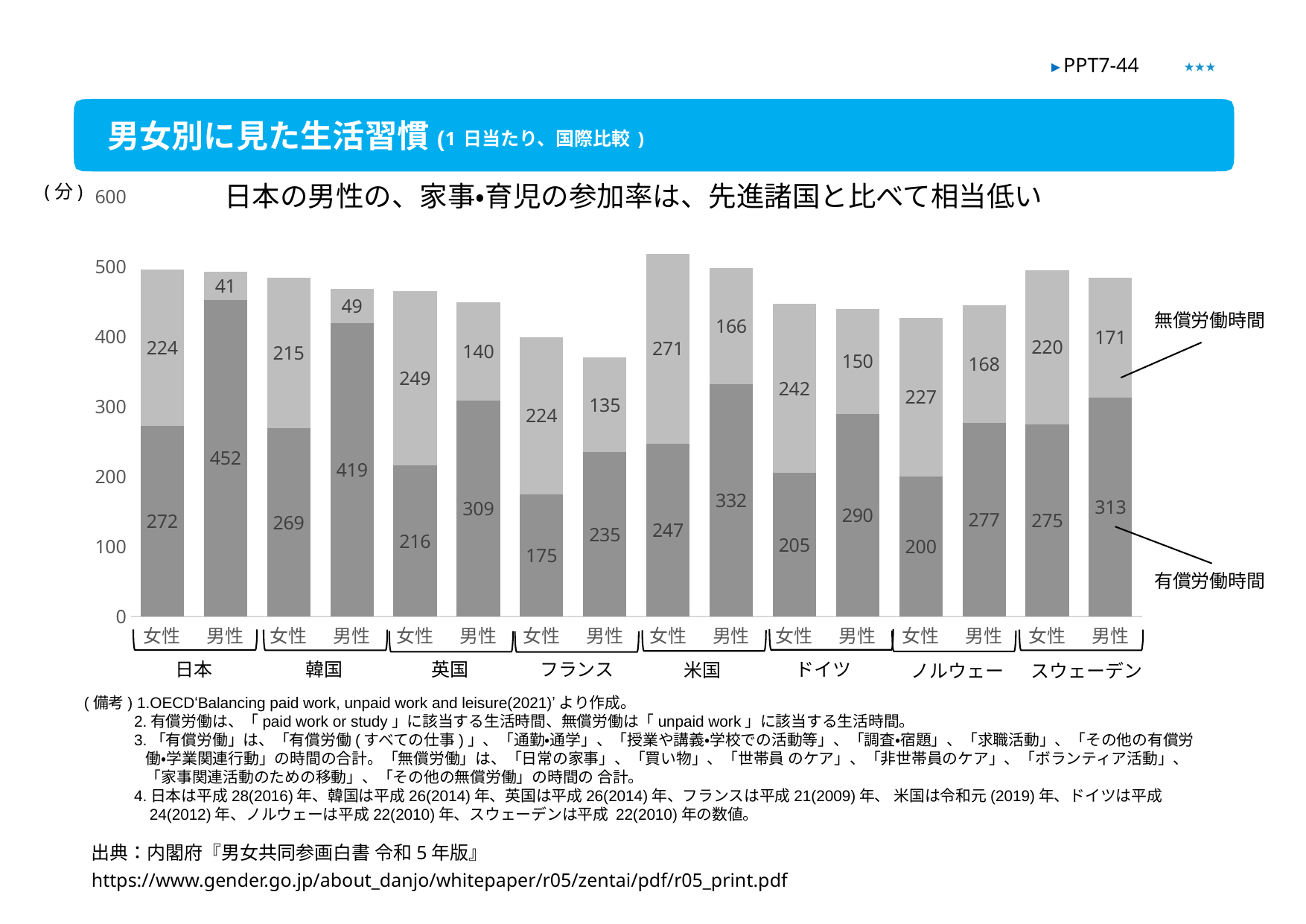
What kind of chart is shown on the slide? Stacked bar chart How many series does the chart show? 2 What is the difference between the 無償労働時間 values for 日本 女性 and 日本 男性? 183 How many bars are plotted in the chart? 16 What is the total of the stacked bar for スウェーデン 男性? 484 What is the 有償労働時間 value for フランス 女性? 175 Which is larger, the 有償労働時間 value for 韓国 男性 or for 英国 男性? 韓国 男性 What is the 有償労働時間 value for 日本 男性? 452 Which bar has the lowest 無償労働時間 value? 日本 男性 Which bar has the highest 有償労働時間 value? 日本 男性 What is the 無償労働時間 value for 米国 女性? 271 What is the total of the stacked bar for ドイツ 女性? 447